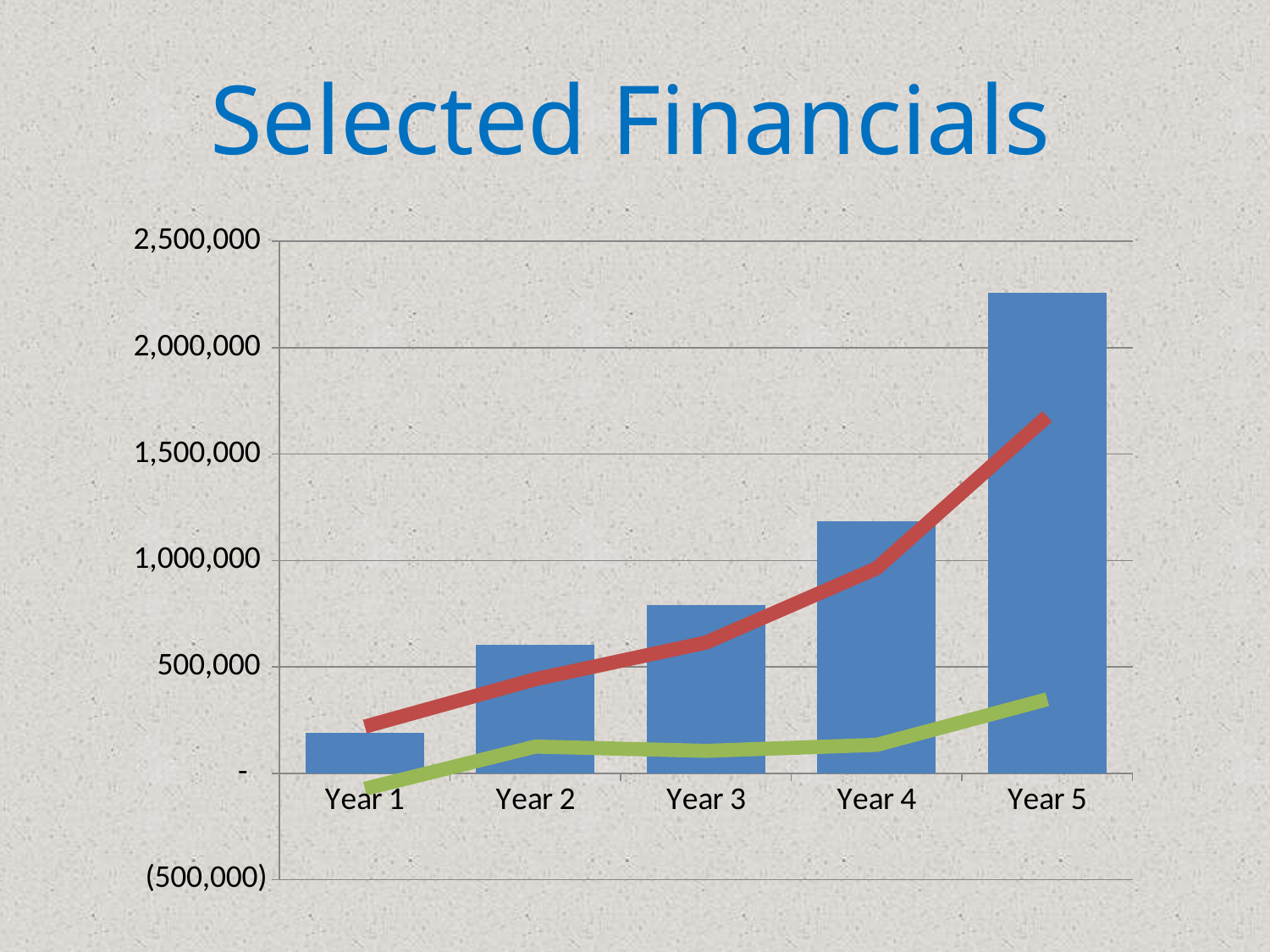
What kind of chart is shown on the slide? A combination bar and line chart Is the blue bar for Year 1 greater or less than 500,000? less Do the blue bars rise or fall from Year 1 to Year 5? Rise Is the red line value for Year 5 greater or less than 1,500,000? greater Which year has the tallest blue bar? Year 5 Is the blue bar for Year 4 greater or less than 1,000,000? greater Which year has the shortest blue bar? Year 1 Which blue bar is taller, Year 3 or Year 4? Year 4 How many years are shown on the x axis of the chart? 5 What is the title of the chart? Selected Financials